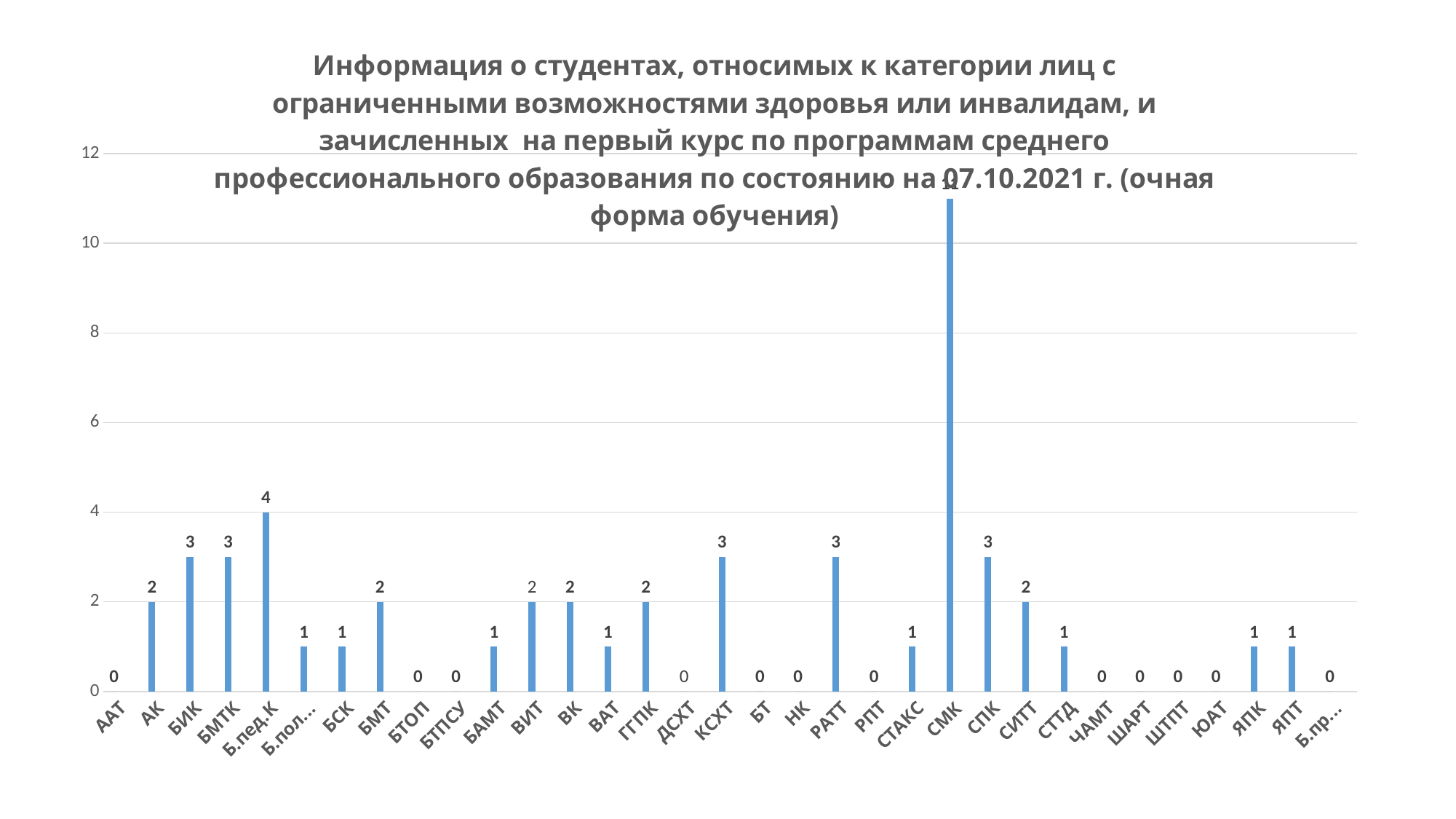
What is the difference between the values for РАТТ and СТАКС? 2 Is the value for СМК greater or less than 10? greater Which is larger, the value for БИК or the value for БСК? БИК What is the value for СИТТ? 2 Which category has the highest value? СМК What is the value for ЯПК? 1 How many categories are shown on the x axis? 33 What kind of chart is shown on the slide? bar chart What is the value for КСХТ? 3 What is the difference between the values for Б.пед.К and АК? 2 What is the value for Б.пед.К? 4 What is the value for ААТ? 0